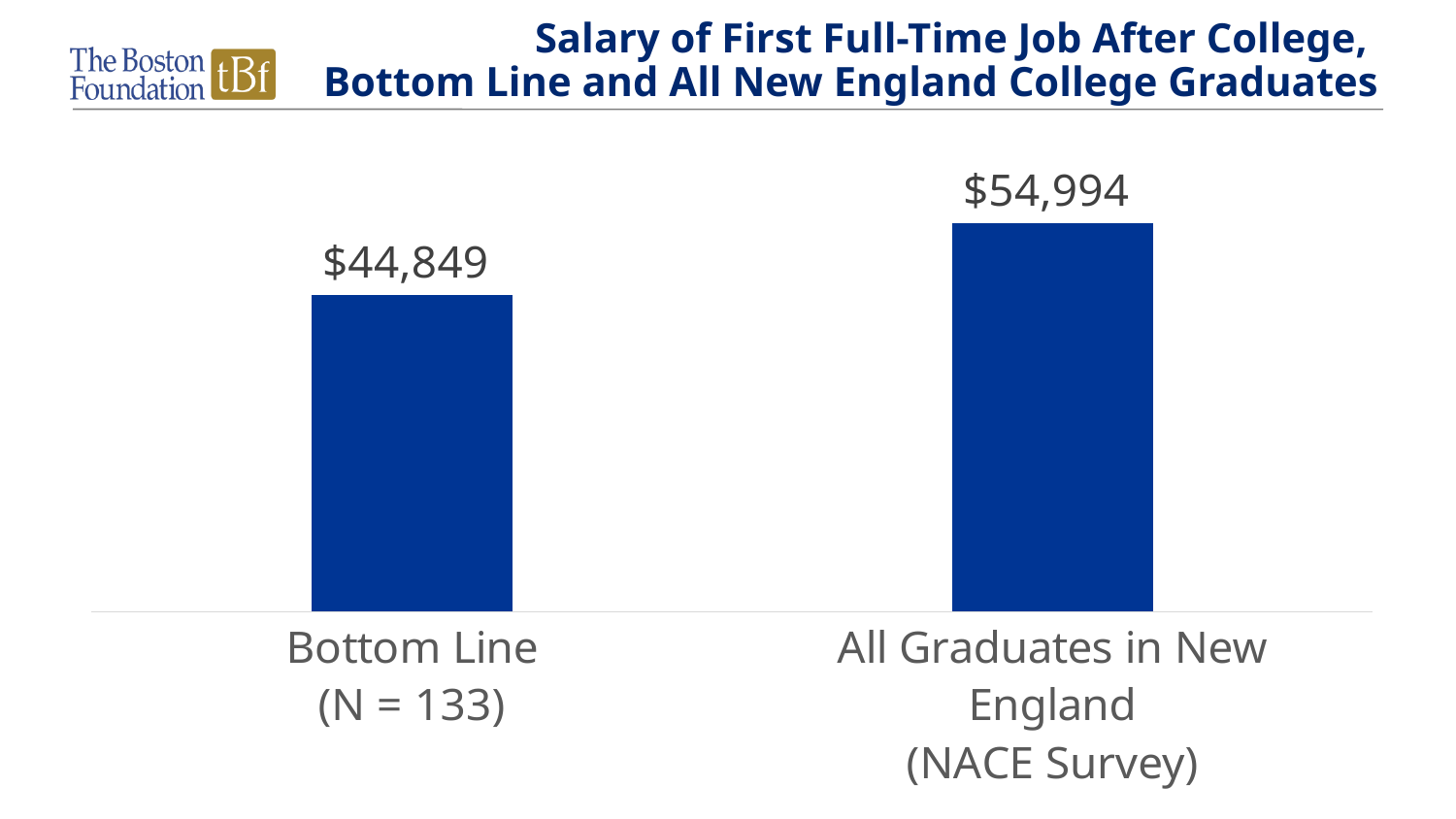
Is the salary for Bottom Line graduates larger or smaller than the salary for All Graduates in New England? smaller What is the difference between the salary for All Graduates in New England and the salary for Bottom Line graduates? $10,145 Which category has the higher first full-time job salary? All Graduates in New England (NACE Survey) What is the salary of the first full-time job after college for All Graduates in New England (NACE Survey)? $54,994 What kind of chart is shown on the slide? bar chart What is the title of the chart? Salary of First Full-Time Job After College, Bottom Line and All New England College Graduates How many categories are shown in the chart? 2 What is the sample size (N) shown for the Bottom Line category? 133 What is the salary of the first full-time job after college for Bottom Line graduates? $44,849 Which category has the lower first full-time job salary? Bottom Line (N = 133)